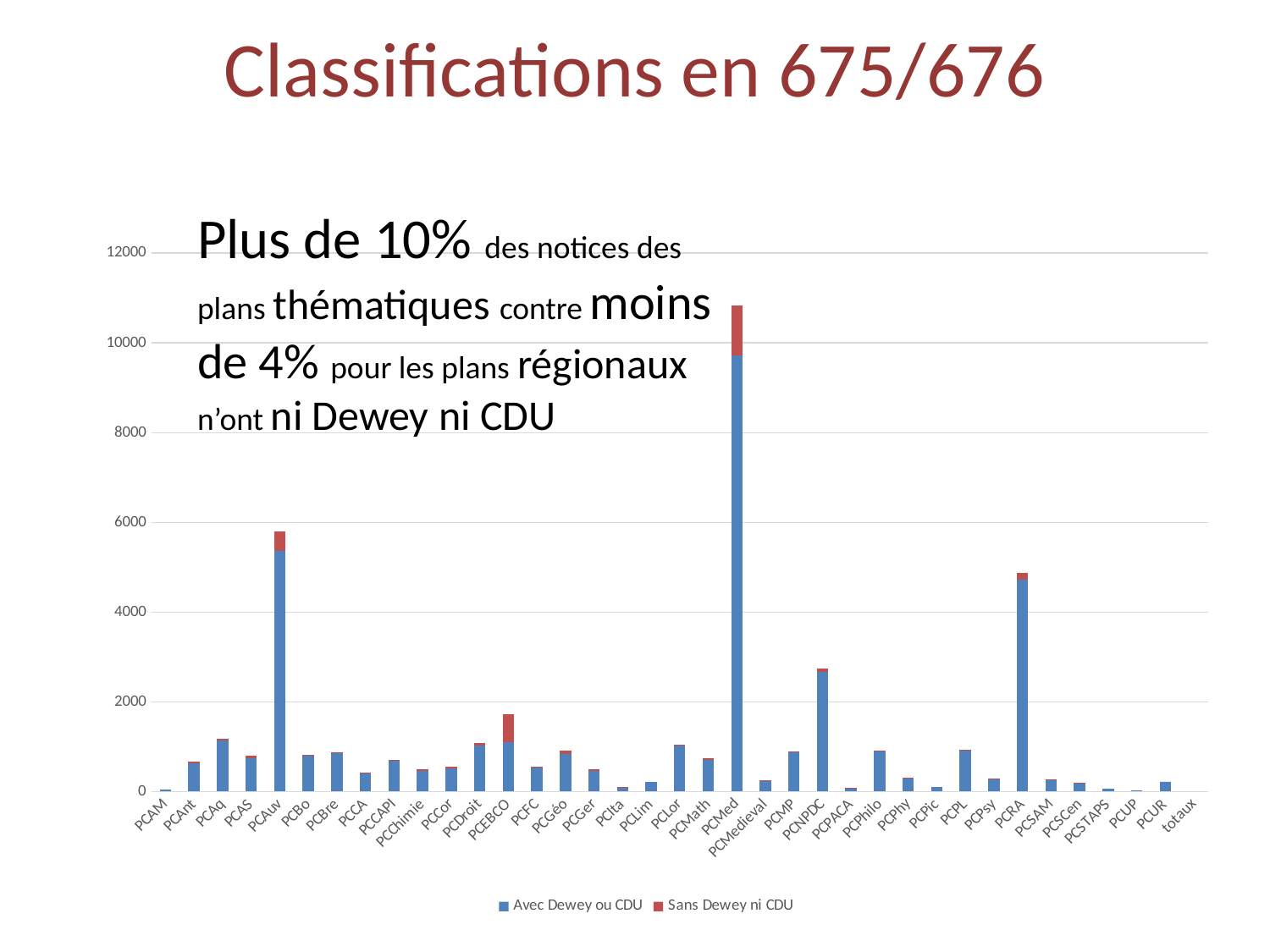
Which series is shown in red in the legend? Sans Dewey ni CDU Is the total value for PCRA greater or less than 6000? less Is the total value for PCNPDC greater or less than 2000? greater Which has the taller bar, PCNPDC or PCMed? PCMed Which has the taller bar, PCAuv or PCRA? PCAuv What is the title of the slide? Classifications en 675/676 Is the total value for PCEBCO greater or less than 2000? less What kind of chart is shown on the slide? bar chart Which category has the tallest bar? PCMed How many series does the legend list? 2